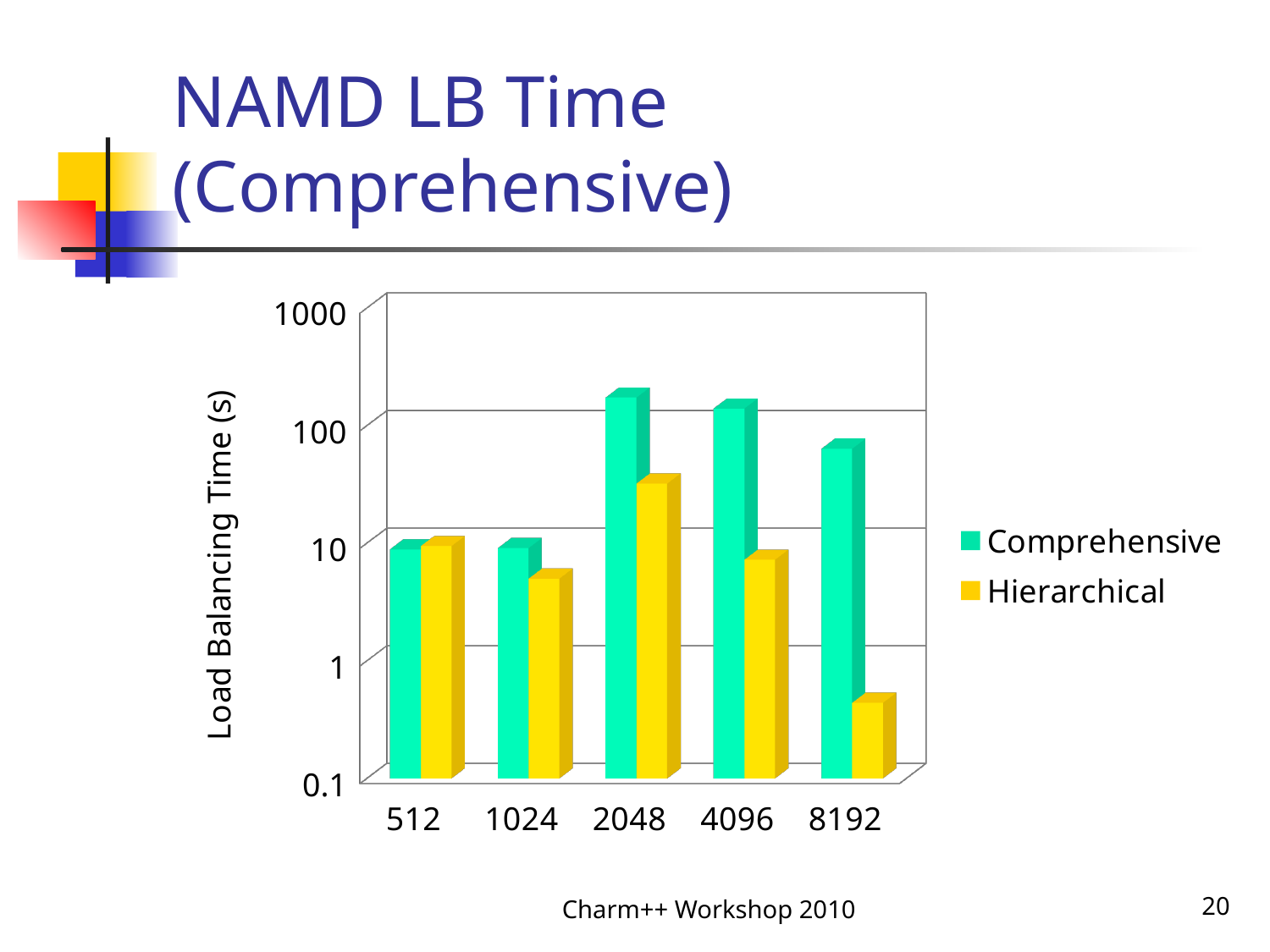
How many series does the legend list? 2 At 8192, which series has the larger value, Comprehensive or Hierarchical? Comprehensive Is the Hierarchical value for 8192 greater or less than 1? less What is the label of the y axis? Load Balancing Time (s) Which series is shown in yellow? Hierarchical Is the Comprehensive value for 2048 greater or less than 100? greater Is the Hierarchical value for 2048 greater or less than 10? greater How many categories are shown on the x axis? 5 What kind of chart is shown on the slide? bar chart For which category is the Hierarchical value highest? 2048 For which category is the Hierarchical value lowest? 8192